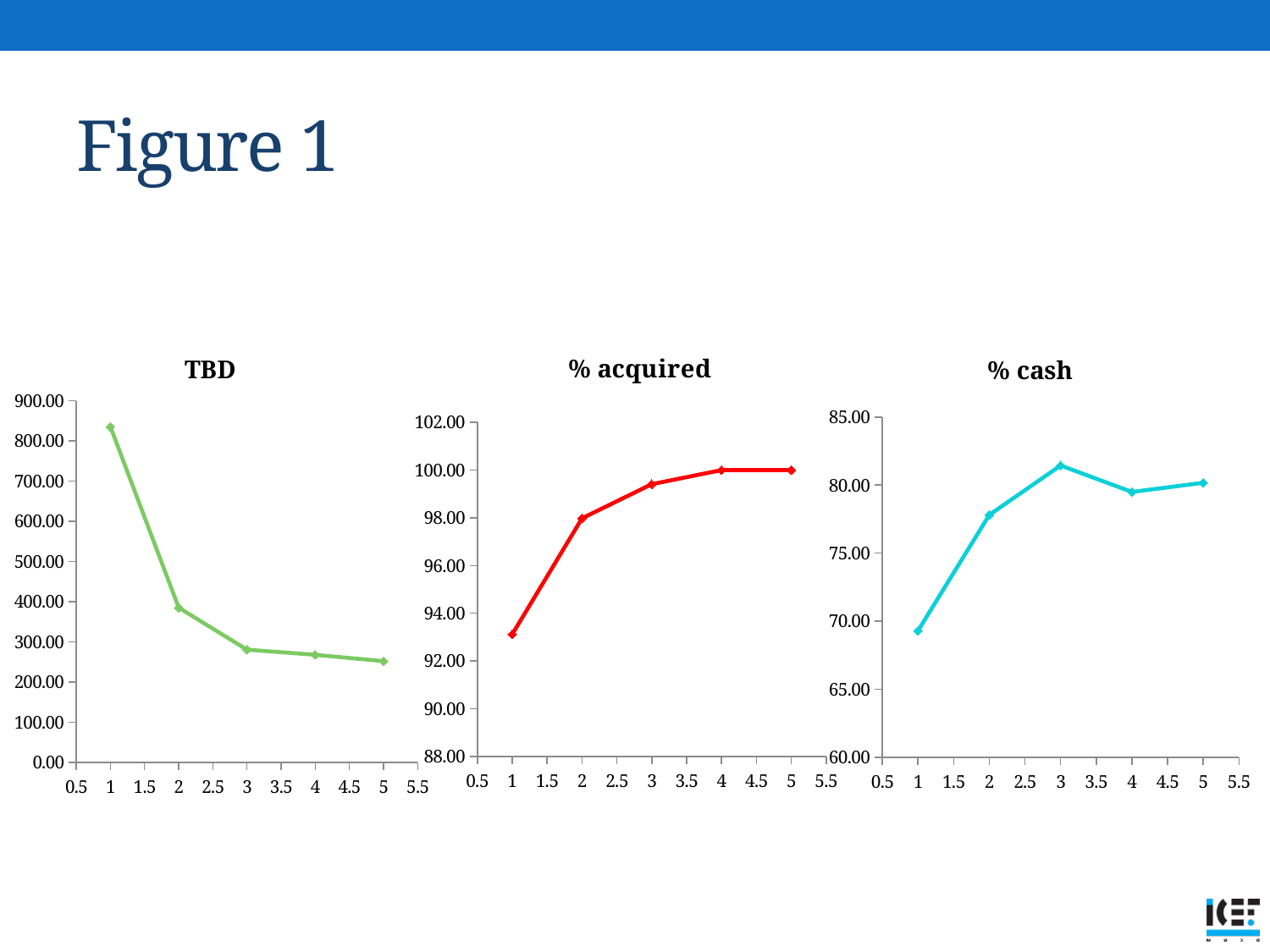
In the "% acquired" chart, at which x value is the plotted value lowest? 1 In the "% cash" chart, is the value at x = 1 greater or less than 70? less In the "TBD" chart, at which x value is the plotted value highest? 1 In the "% acquired" chart, do the values rise or fall as x increases from 1 to 4? rise In the "TBD" chart, how many data points are plotted? 5 What kind of chart is the "TBD" chart? line chart In the "% acquired" chart, is the value at x = 1 greater or less than 94? less In the "% cash" chart, which is larger, the value at x = 1 or the value at x = 2? x = 2 In the "TBD" chart, do the values rise or fall as x increases from 1 to 5? fall In the "TBD" chart, is the value at x = 1 greater or less than 800? greater How many charts are shown on the slide? 3